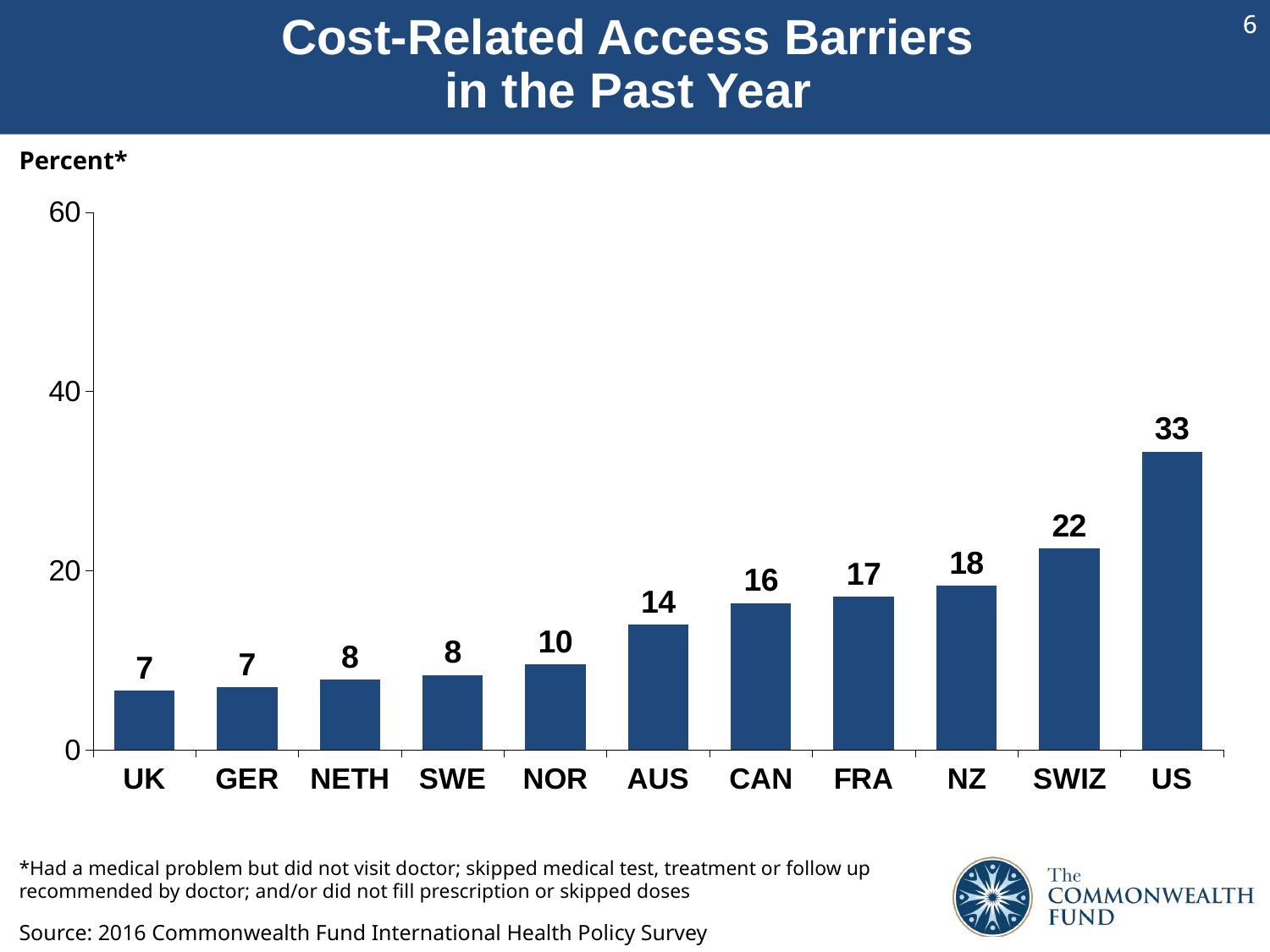
Do the values rise or fall from left to right along the x axis? rise What kind of chart is shown on the slide? bar chart Is the value for SWIZ greater or less than 20? greater What is the difference between the values for the US and SWIZ? 11 What is the value for NOR? 10 What is the value for the US? 33 Which is larger, the value for AUS or the value for FRA? FRA Which country has the highest value? US What is the difference between the values for NZ and UK? 11 What is the value for CAN? 16 What is the title of the chart? Cost-Related Access Barriers in the Past Year How many countries are shown on the chart? 11